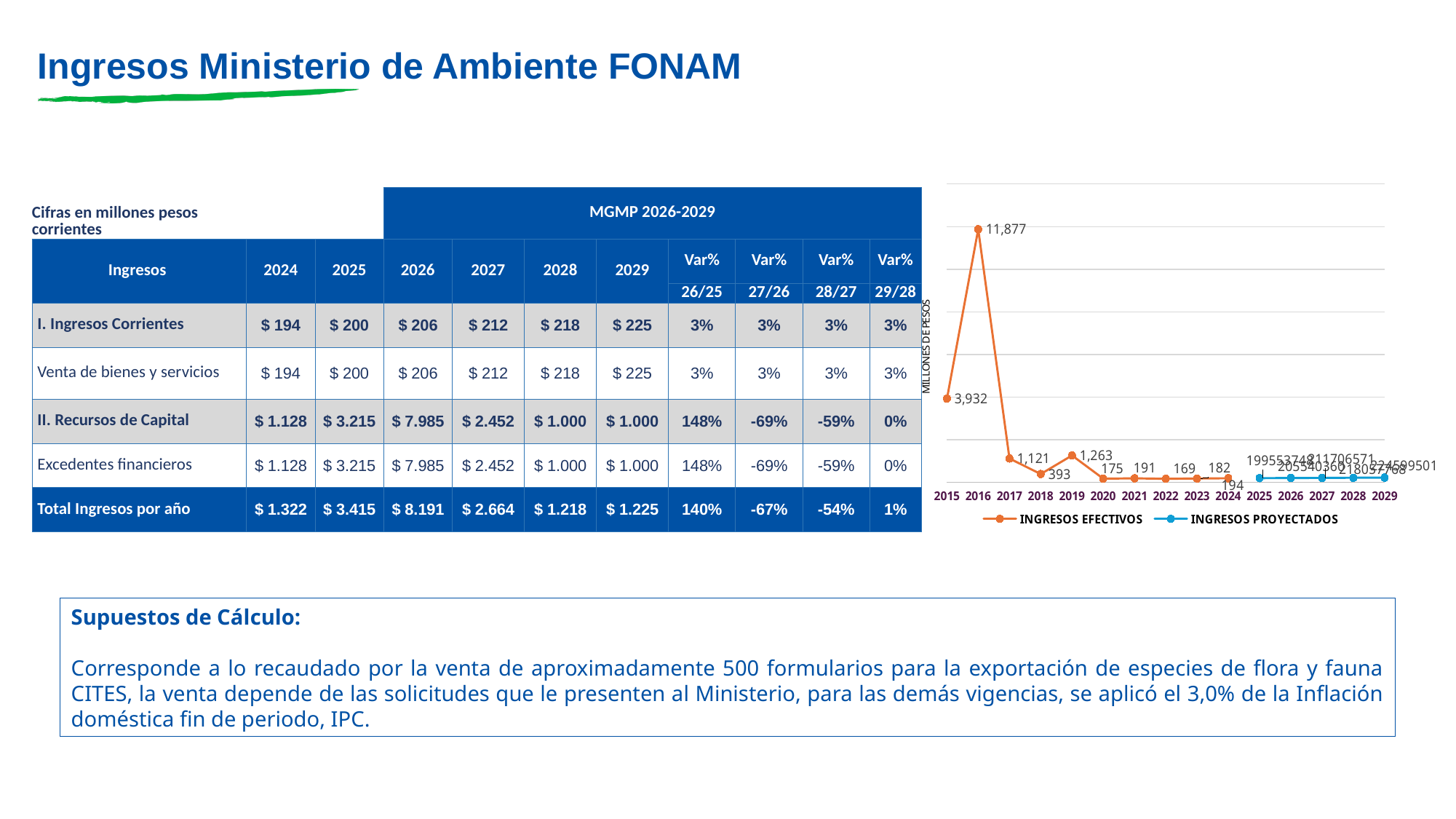
How many series does the legend of the line chart list? 2 In the line chart, what is the INGRESOS EFECTIVOS value for 2015? 3,932 What kind of chart is shown on the right side of the slide? line chart In the line chart, what is the INGRESOS EFECTIVOS value for 2024? 194 In the line chart, what is the INGRESOS EFECTIVOS value for 2016? 11,877 In the line chart, what is the INGRESOS EFECTIVOS value for 2018? 393 In the line chart, which is larger, the INGRESOS EFECTIVOS value for 2017 or for 2019? 2019 In the line chart, what is the difference between the INGRESOS EFECTIVOS values for 2016 and 2015? 7,945 In the line chart, which year between 2020 and 2024 has the lowest INGRESOS EFECTIVOS value? 2022 In the line chart, which year has the highest value for INGRESOS EFECTIVOS? 2016 What is the label on the vertical axis of the line chart? MILLONES DE PESOS How many years are shown on the x axis of the line chart? 15